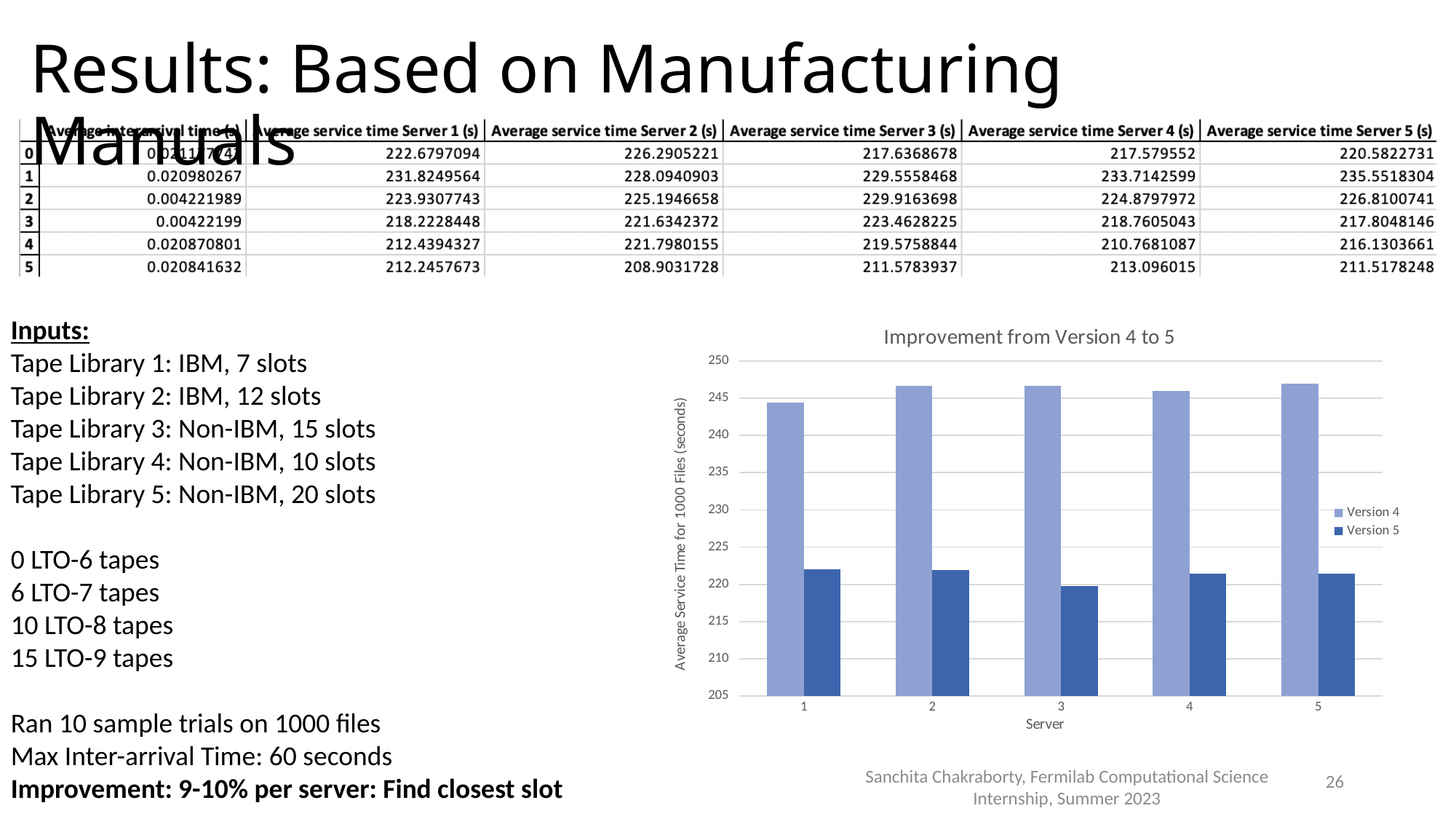
Is the Version 5 value for Server 3 greater or less than 225? less How many series does the chart's legend list? 2 How many servers are shown on the x axis of the chart? 5 What is the label of the chart's y axis? Average Service Time for 1000 Files (seconds) Is the Version 4 value for Server 1 greater or less than 240? greater What is the title of the chart? Improvement from Version 4 to 5 What kind of chart is shown on the slide? bar chart For Server 3, which is larger, the Version 4 value or the Version 5 value? Version 4 Is the Version 5 value for Server 1 greater or less than 225? less Which server has the lowest Version 5 value? 3 Which server has the lowest Version 4 value? 1